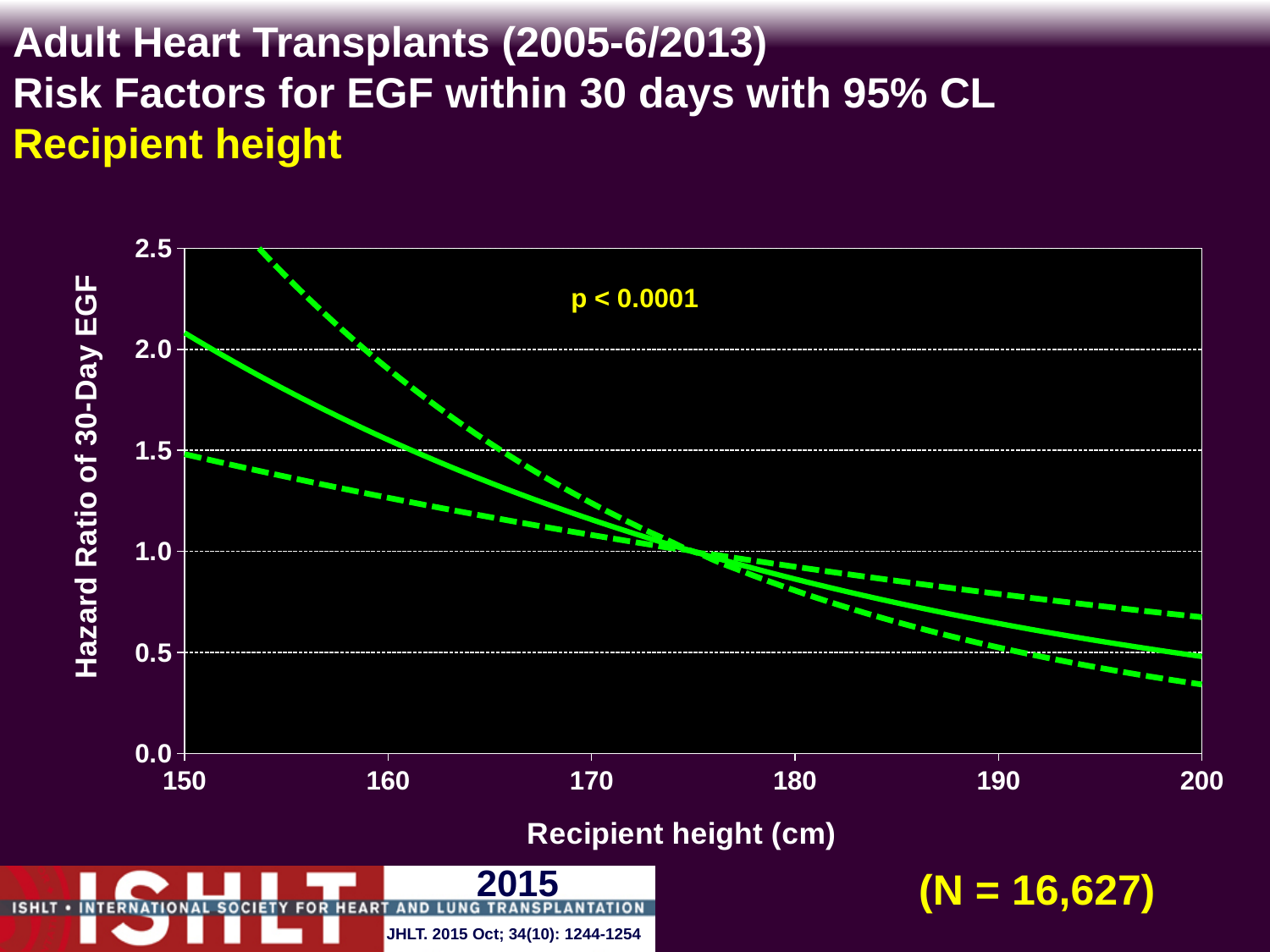
Is the hazard ratio (solid line) at a recipient height of 150 cm greater or less than 1.5? greater What kind of chart is shown on the slide? line chart What is the label of the x axis? Recipient height (cm) What p-value is printed on the chart? p < 0.0001 Is the lower dashed confidence limit at a recipient height of 200 cm greater or less than 0.5? less Does the hazard ratio of 30-day EGF rise or fall as recipient height increases from 150 to 200 cm? fall Is the hazard ratio (solid line) at a recipient height of 190 cm greater or less than 1.0? less How many lines are plotted on the chart? 3